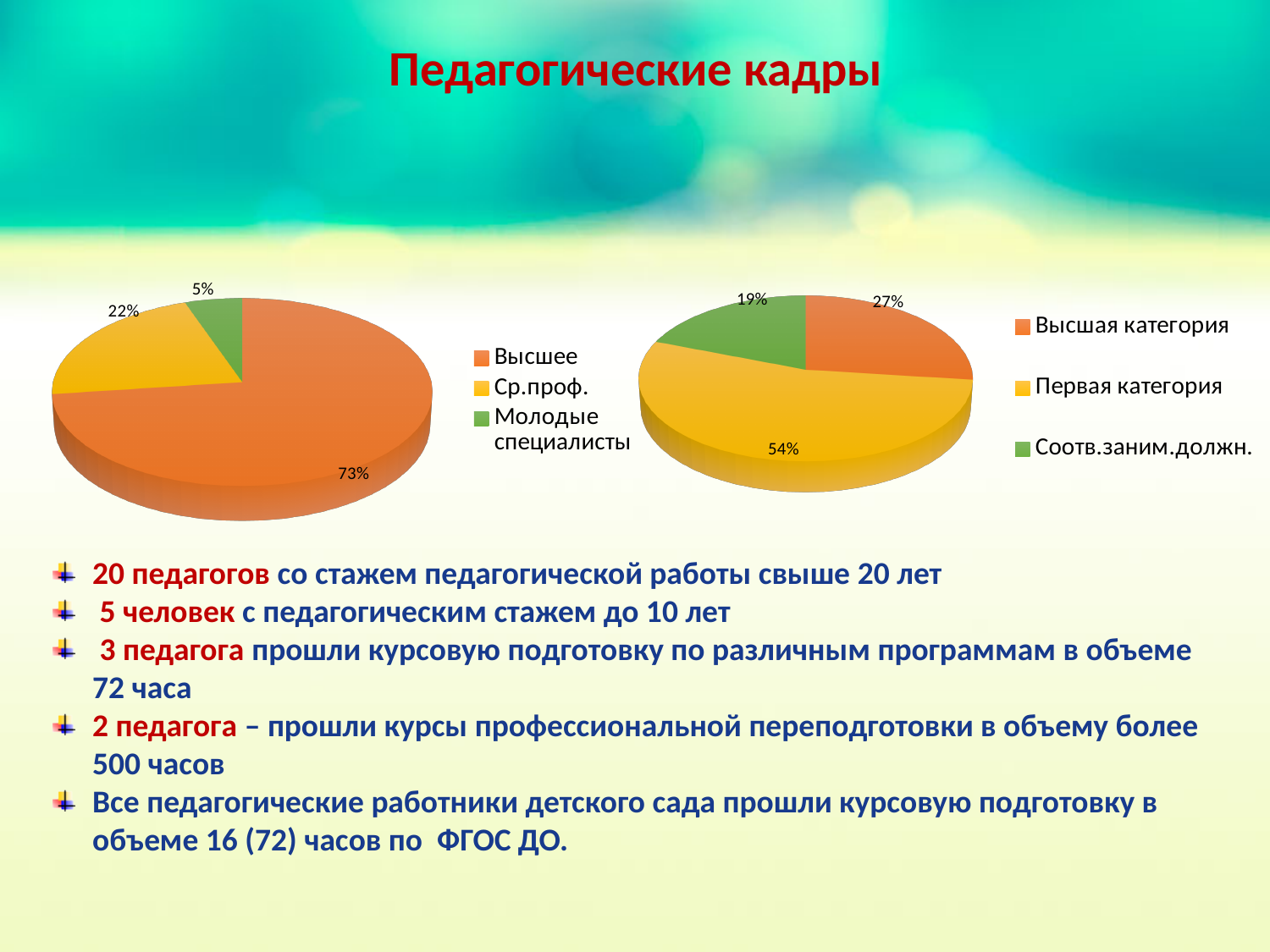
In the left pie chart, what share is labelled for Ср.проф.? 22% In the right pie chart, what share is labelled for Соотв.заним.должн.? 19% In the left pie chart, what share is labelled for Высшее? 73% In the left pie chart, which category has the smallest slice? Молодые специалисты In the right pie chart, which is larger: Высшая категория or Соотв.заним.должн.? Высшая категория In the left pie chart, which category has the largest slice? Высшее In the right pie chart, what share is labelled for Высшая категория? 27% In the left pie chart, what share is labelled for Молодые специалисты? 5% In the right pie chart, what share is labelled for Первая категория? 54% In the right pie chart, which category has the largest slice? Первая категория In the left pie chart, what is the difference in percentage points between Высшее and Ср.проф.? 51 How many slices does the right pie chart have? 3